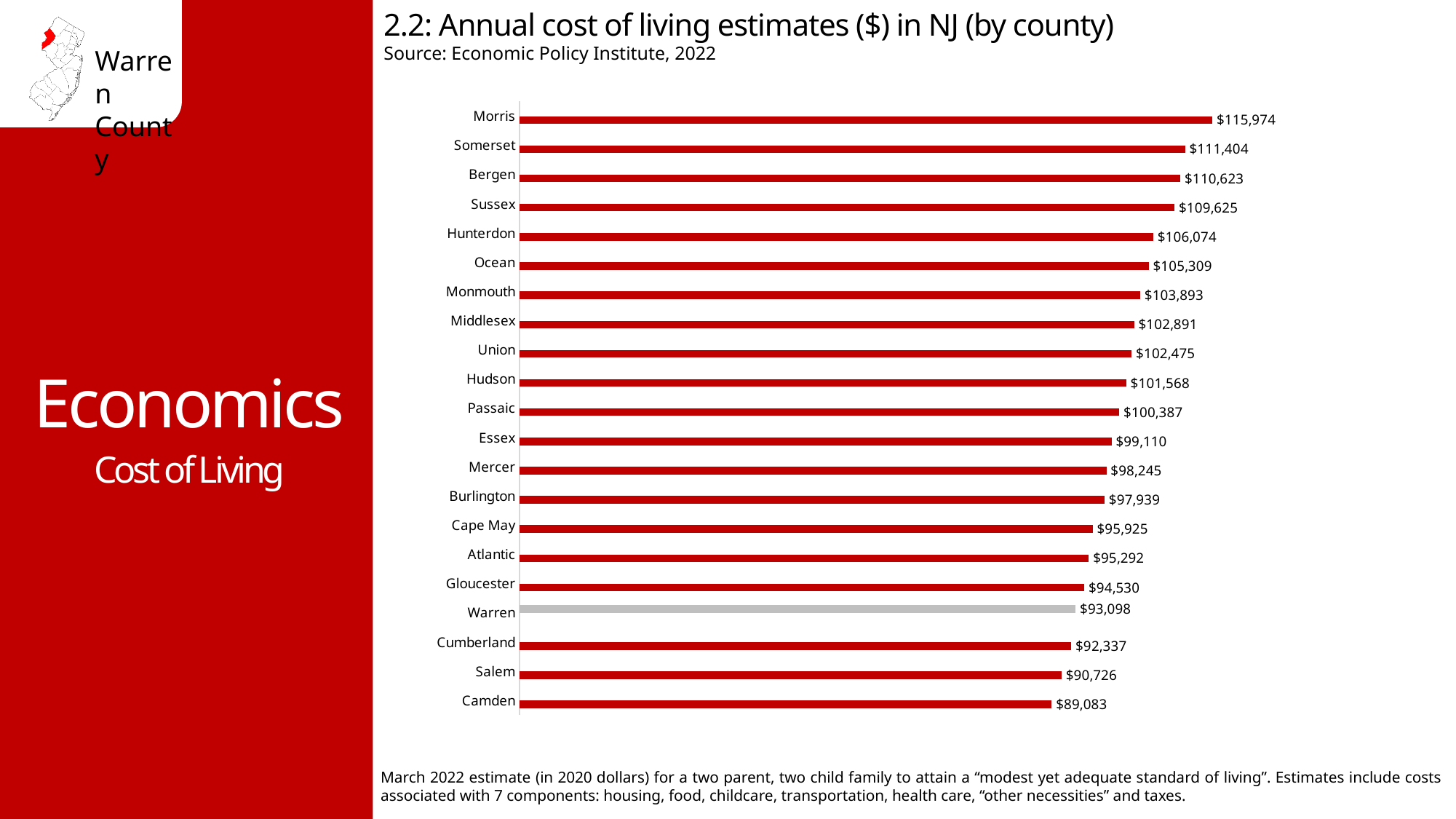
What is the annual cost of living estimate for Hunterdon County? $106,074 What is the annual cost of living estimate for Warren County? $93,098 Which county has the lowest annual cost of living estimate? Camden What is the difference between the cost of living estimates for Warren and Cumberland counties? $761 Which county has a higher cost of living estimate, Salem or Gloucester? Gloucester Which county has the highest annual cost of living estimate? Morris What is the annual cost of living estimate for Cape May County? $95,925 Which county's bar is shown in gray instead of red? Warren What type of chart is used to show the annual cost of living estimates? Bar chart What is the difference between the cost of living estimates for Morris and Camden counties? $26,891 Which county has a higher cost of living estimate, Bergen or Ocean? Bergen How many counties are shown in the chart? 21